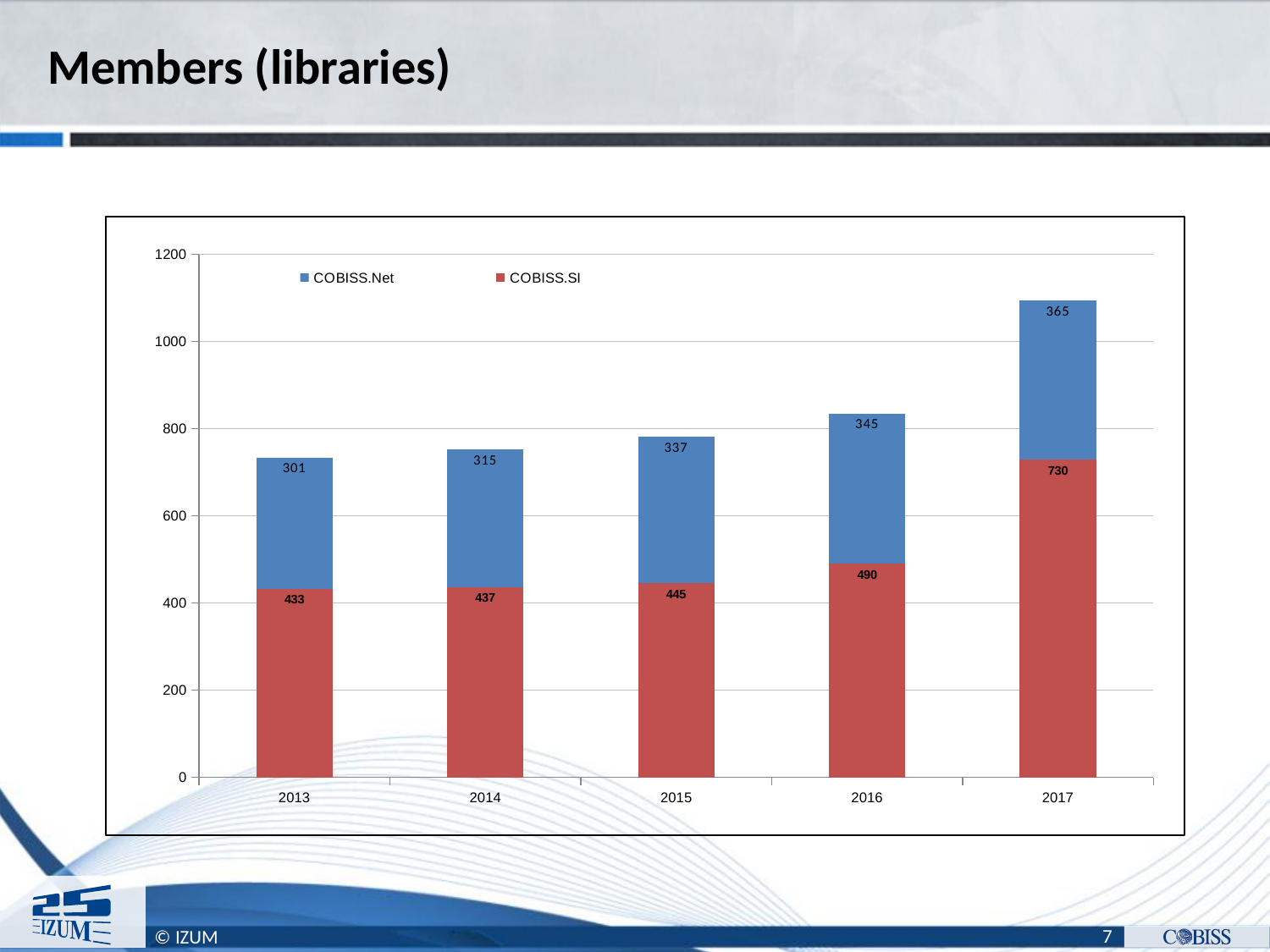
What is the COBISS.Net value for 2014? 315 What is the difference between the COBISS.SI values for 2017 and 2016? 240 Which year has the lowest COBISS.SI value? 2013 What is the COBISS.SI value for 2016? 490 What is the total of the stacked bar for 2017? 1095 How many years are shown on the x axis? 5 What kind of chart is shown on the slide? Stacked bar chart How many series does the legend list? 2 Which is larger, the COBISS.Net value for 2015 or the COBISS.Net value for 2016? 2016 What is the COBISS.SI value for 2013? 433 What is the total of the stacked bar for 2013? 734 Which year has the highest COBISS.Net value? 2017